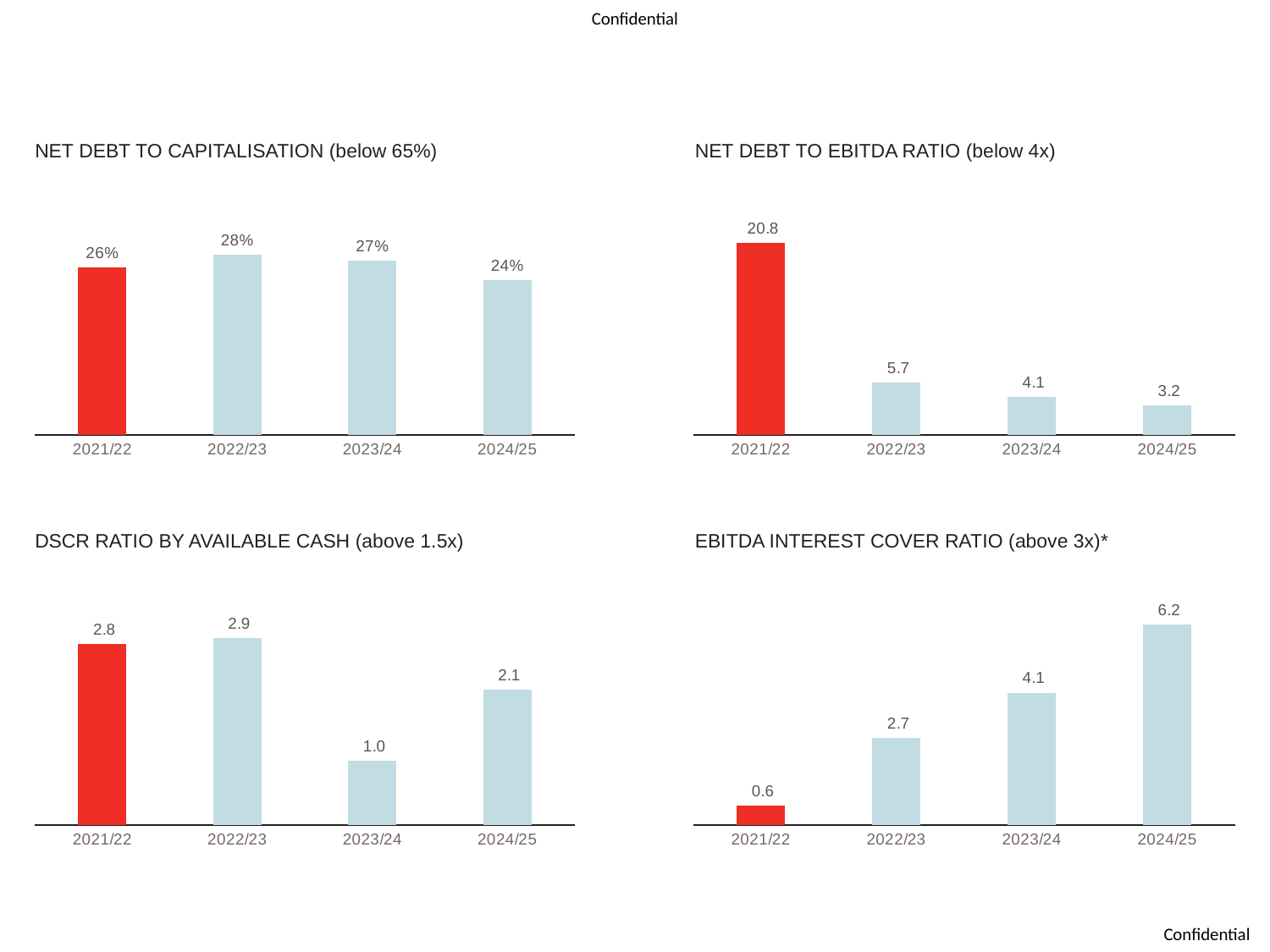
What kind of chart is the NET DEBT TO CAPITALISATION chart? bar chart In the NET DEBT TO EBITDA RATIO chart, what is the value for 2021/22? 20.8 In the NET DEBT TO EBITDA RATIO chart, what is the difference between the 2021/22 and 2022/23 values? 15.1 In the DSCR RATIO BY AVAILABLE CASH chart, which year has the highest value? 2022/23 In the NET DEBT TO EBITDA RATIO chart, do the values rise or fall from 2021/22 to 2024/25? fall In the NET DEBT TO CAPITALISATION chart, which year has the lowest value? 2024/25 In the DSCR RATIO BY AVAILABLE CASH chart, what is the value for 2023/24? 1.0 In the EBITDA INTEREST COVER RATIO chart, which is larger, the value for 2022/23 or 2023/24? 2023/24 How many years are shown in the DSCR RATIO BY AVAILABLE CASH chart? 4 In the EBITDA INTEREST COVER RATIO chart, what is the value for 2024/25? 6.2 In the EBITDA INTEREST COVER RATIO chart, do the values rise or fall from 2021/22 to 2024/25? rise In the NET DEBT TO CAPITALISATION chart, what is the value for 2022/23? 28%